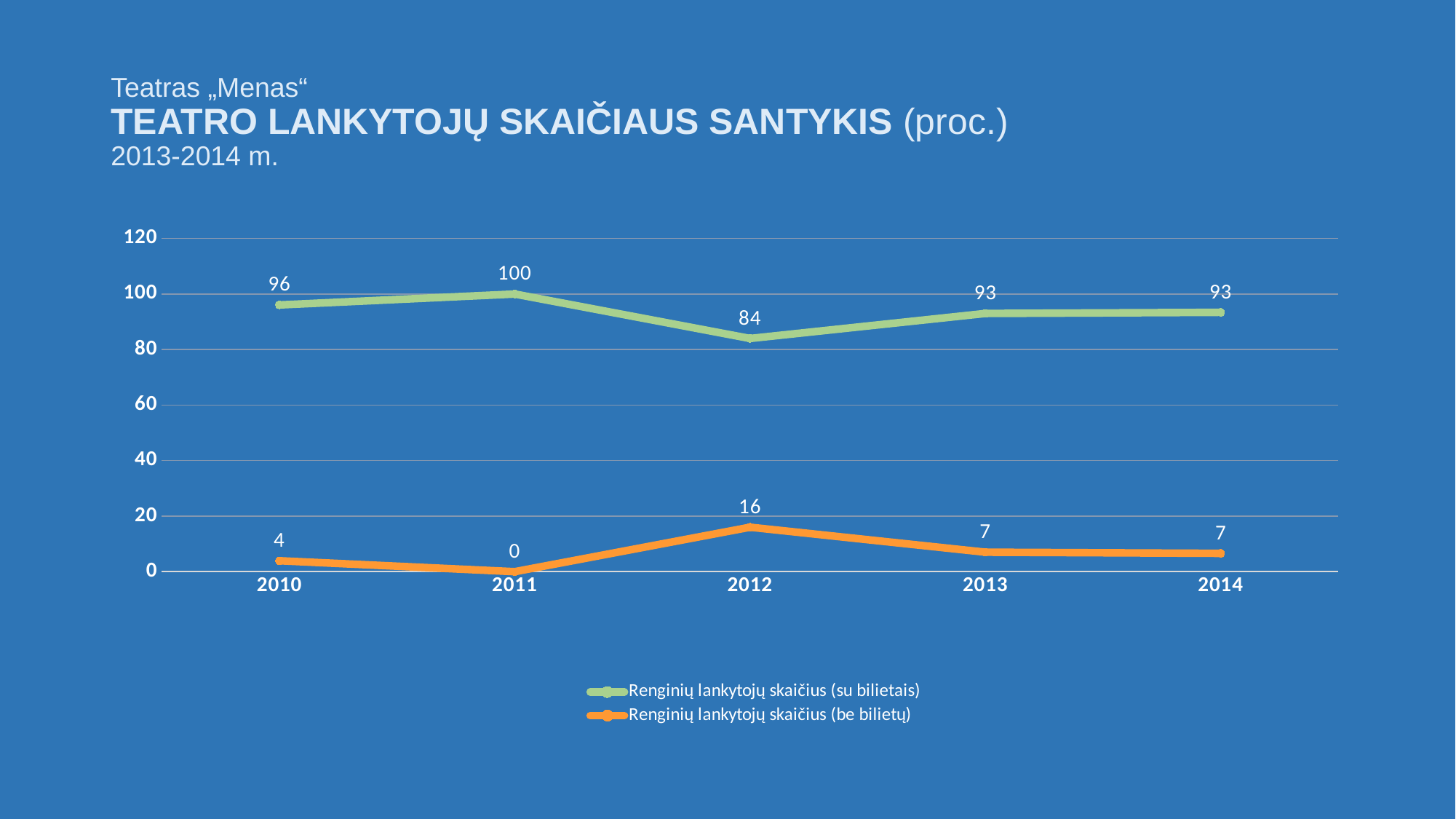
How many series does the legend list? 2 What is the value for "Renginių lankytojų skaičius (be bilietų)" in 2012? 16 In which year is "Renginių lankytojų skaičius (su bilietais)" lowest? 2012 What is the value for "Renginių lankytojų skaičius (su bilietais)" in 2012? 84 What is the value for "Renginių lankytojų skaičius (be bilietų)" in 2011? 0 Which colour is used for the "Renginių lankytojų skaičius (be bilietų)" series? Orange What is the difference between the "su bilietais" and "be bilietų" values in 2010? 92 In which year is "Renginių lankytojų skaičius (su bilietais)" highest? 2011 Which is larger: the "su bilietais" value in 2010 or in 2013? 2010 In which year is "Renginių lankytojų skaičius (be bilietų)" highest? 2012 How many years are shown on the x axis? 5 What kind of chart is shown on the slide? Line chart